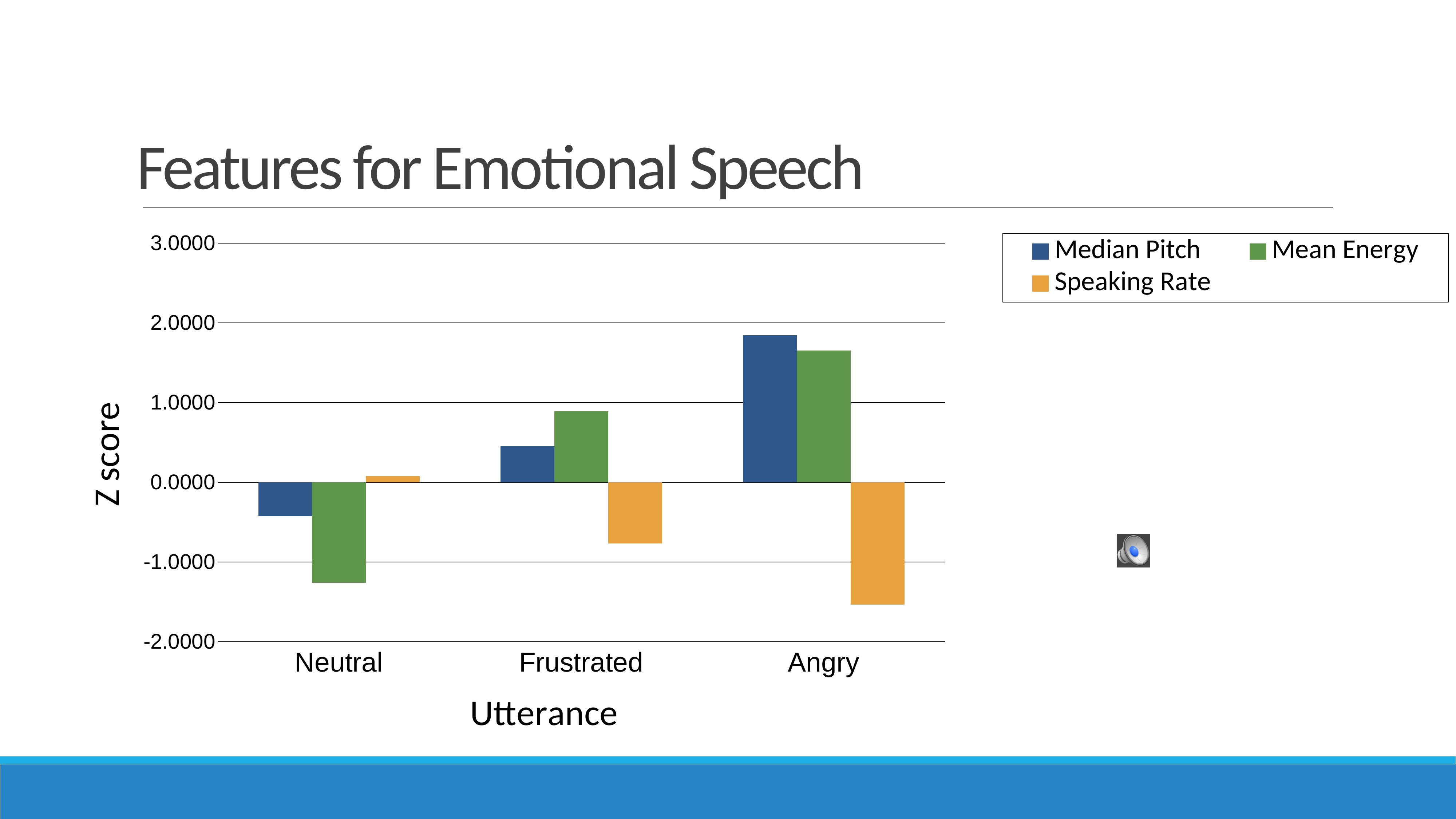
Which utterance category has the lowest Mean Energy z score? Neutral Is the Mean Energy value for Angry greater or less than 1.0000? greater For Frustrated, which is larger: Median Pitch or Mean Energy? Mean Energy What is the label on the y axis? Z score Does the Median Pitch z score rise or fall from Neutral to Frustrated to Angry? rise How many utterance categories are shown on the x axis? 3 Is the Mean Energy value for Neutral greater or less than -1.0000? less Is the Median Pitch value for Angry greater or less than 2.0000? less What kind of chart is shown on the slide? bar chart How many series does the legend list? 3 Which utterance category has the highest Median Pitch z score? Angry Which utterance category has the lowest Speaking Rate z score? Angry